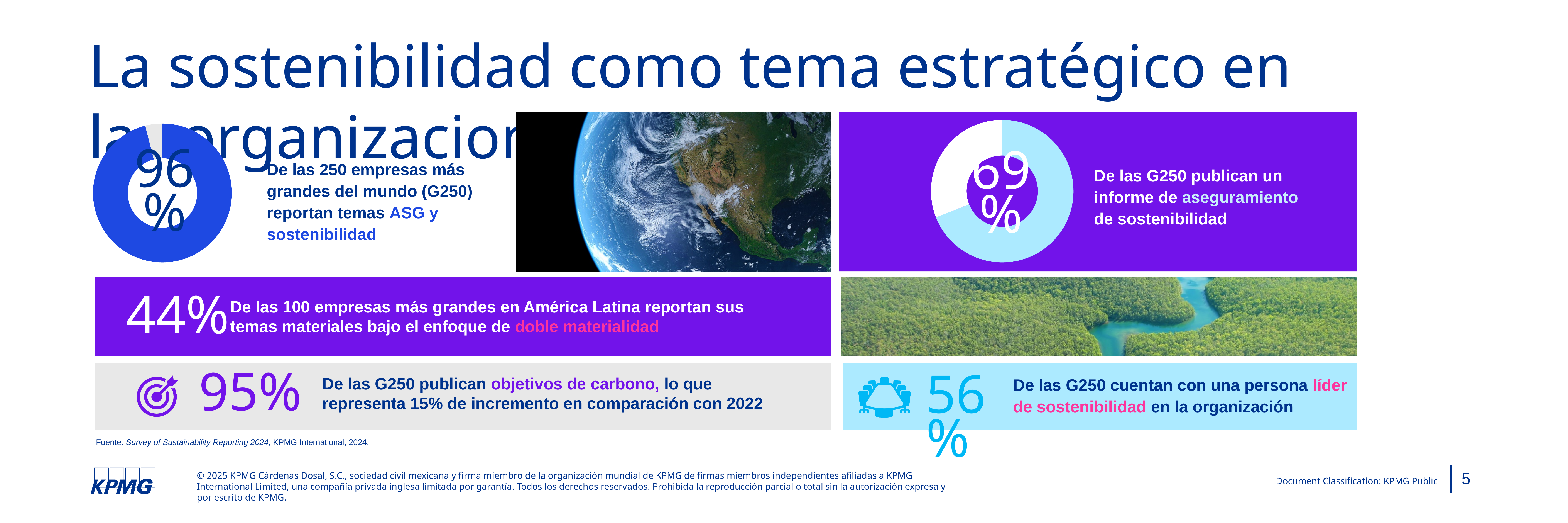
What does the top-right donut chart (69%) describe about the G250 companies? They publish a sustainability assurance report (informe de aseguramiento de sostenibilidad) How many donut charts are on the slide? 2 What is the difference between the value in the top-left donut chart and the value in the top-right donut chart? 27 percentage points What percentage does the top-left donut chart show? 96% What share of the top-left donut chart is filled in dark blue? 96% Which donut chart shows the larger value, the top-left one or the top-right one? The top-left one (96%) What colour is the filled portion of the top-left donut chart? Blue What percentage does the donut chart on the purple panel at the top right show? 69% What share of the top-right donut chart is left unfilled (white)? 31% In the top-right donut chart, is the highlighted value greater or less than 50%? greater What kind of chart is used to show the 96% figure at the top left? Donut (pie) chart